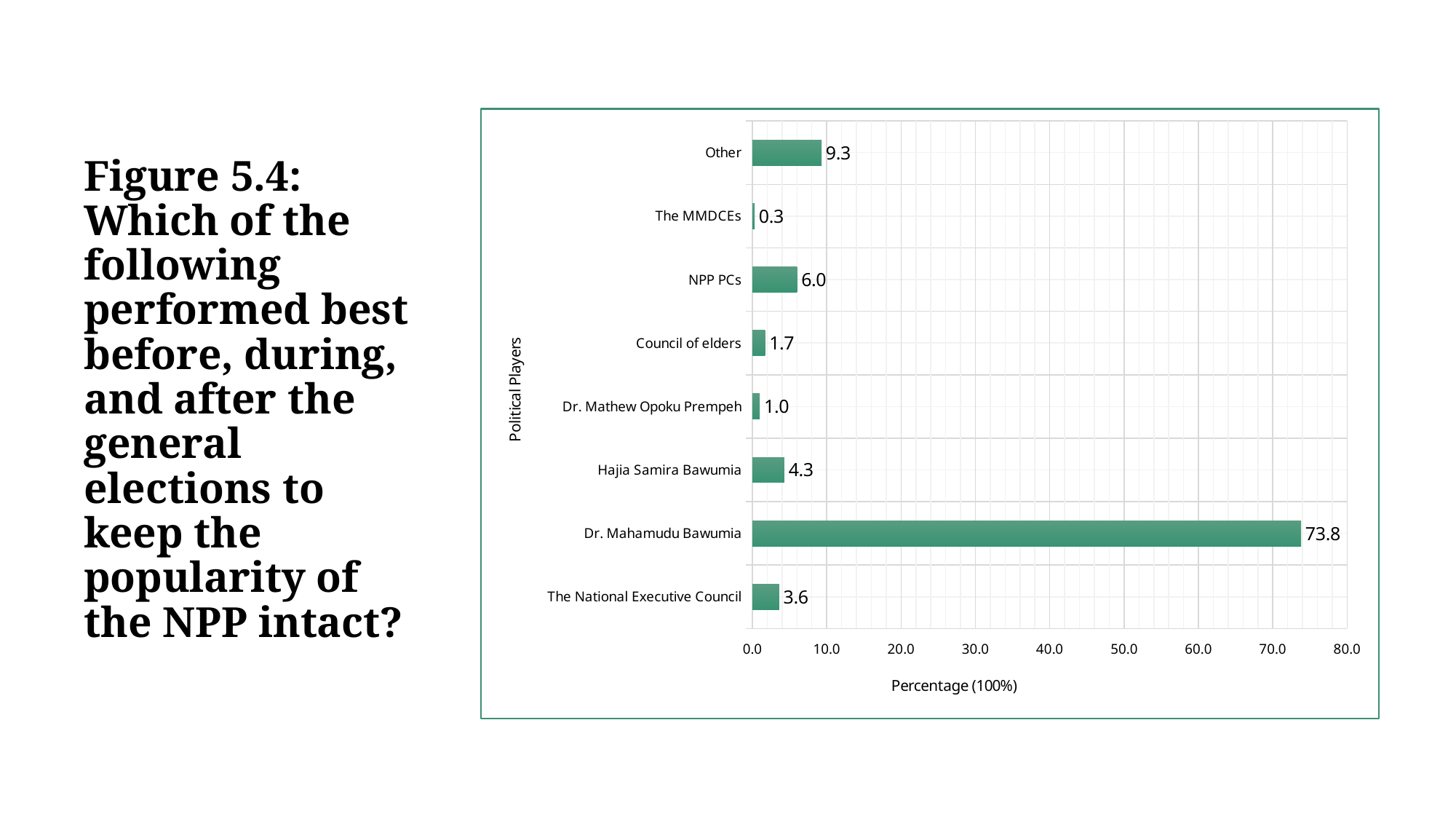
What is the difference between the values for Dr. Mahamudu Bawumia and Other? 64.5 Is the value for Dr. Mahamudu Bawumia greater or less than 70.0? greater What is the value for Hajia Samira Bawumia? 4.3 What is the value for The MMDCEs? 0.3 What is the value for Other? 9.3 What kind of chart is shown on the slide? Bar chart Which category has the highest value? Dr. Mahamudu Bawumia What is the value for Dr. Mahamudu Bawumia? 73.8 What is the difference between the values for NPP PCs and Council of elders? 4.3 Which category has the lowest value? The MMDCEs How many categories are shown on the chart? 8 Which is larger, the value for NPP PCs or the value for The National Executive Council? NPP PCs